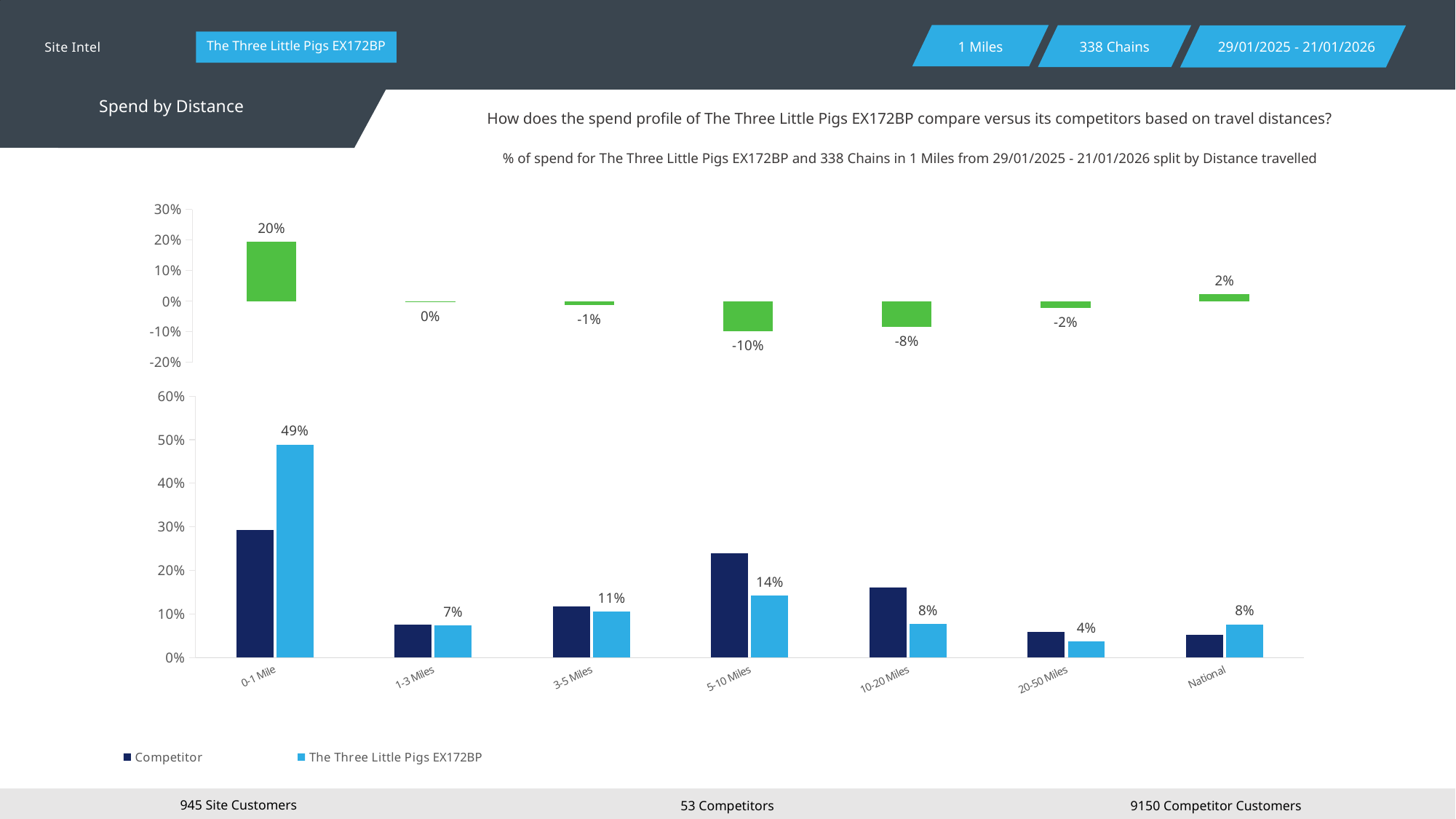
In the bottom chart, what is the difference between The Three Little Pigs EX172BP values at 0-1 Mile and 5-10 Miles? 35 percentage points In the bottom chart, what is the value for The Three Little Pigs EX172BP at 0-1 Mile? 49% In the bottom chart, which distance category has the lowest value for The Three Little Pigs EX172BP? 20-50 Miles In the bottom chart, which distance category has the highest value for The Three Little Pigs EX172BP? 0-1 Mile In the bottom chart, what is the value for The Three Little Pigs EX172BP at 5-10 Miles? 14% How many series does the legend of the bottom chart list? 2 How many distance categories are shown on the x axis of the bottom chart? 7 In the bottom chart, at 5-10 Miles, which series has the larger value: Competitor or The Three Little Pigs EX172BP? Competitor In the bottom chart, is the Competitor value at 0-1 Mile greater or less than 20%? greater In the top chart, what is the value of the first (leftmost) green bar? 20% In the bottom chart, is the Competitor value at 10-20 Miles greater or less than 10%? greater What kind of chart is the bottom chart? bar chart